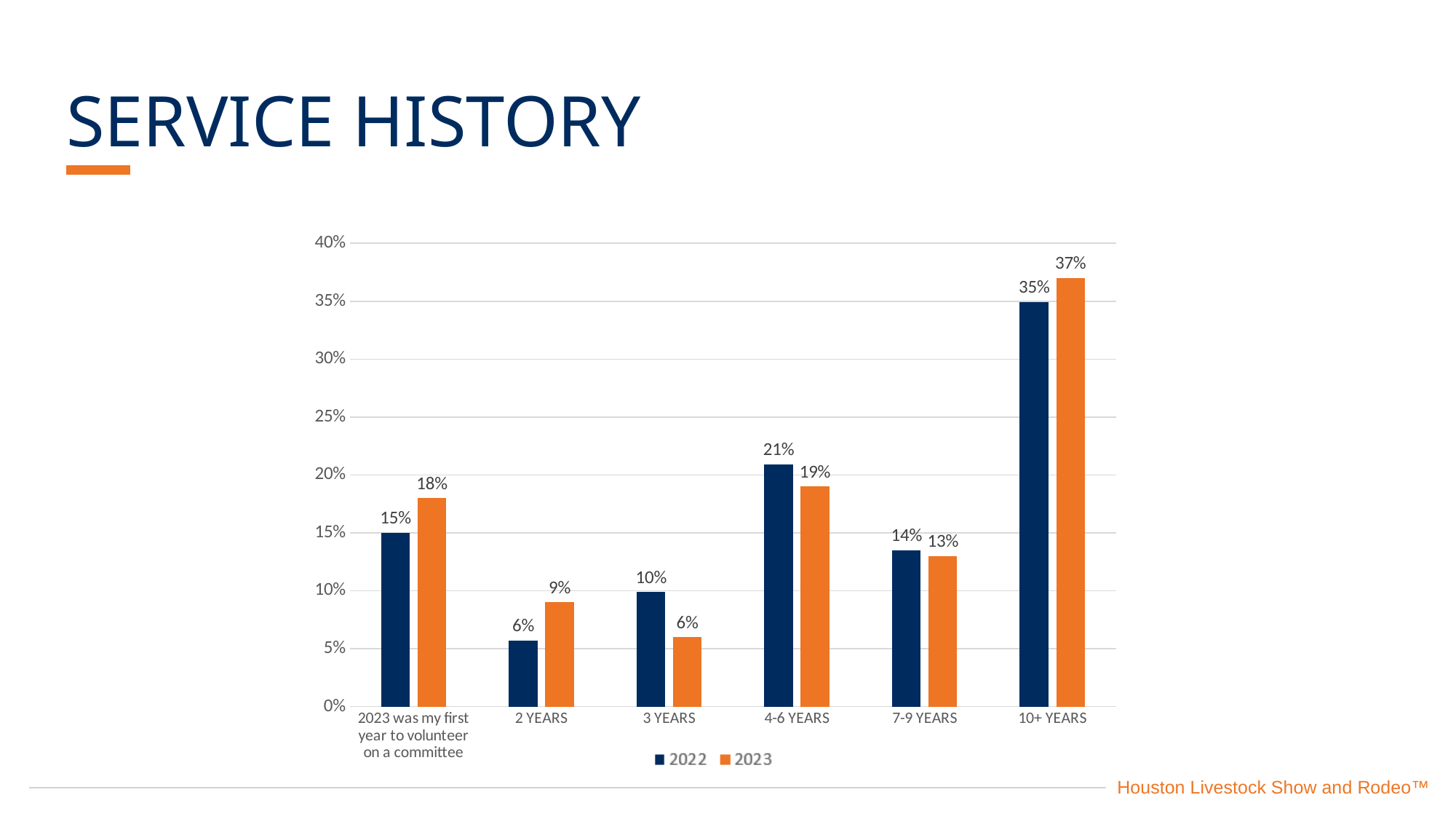
Which category has the highest 2022 value? 10+ YEARS How many series does the legend list? 2 What is the difference between the 2023 and 2022 values for 3 YEARS? 4% What is the 2023 value for 10+ YEARS? 37% What is the 2022 value for 4-6 YEARS? 21% What is the title of the slide? SERVICE HISTORY For 7-9 YEARS, which series has the larger value, 2022 or 2023? 2022 What is the 2023 value for 2 YEARS? 9% What kind of chart is shown on the slide? Bar chart Which category has the lowest 2023 value? 3 YEARS Which colour represents the 2023 series? Orange How many categories are shown on the x axis? 6